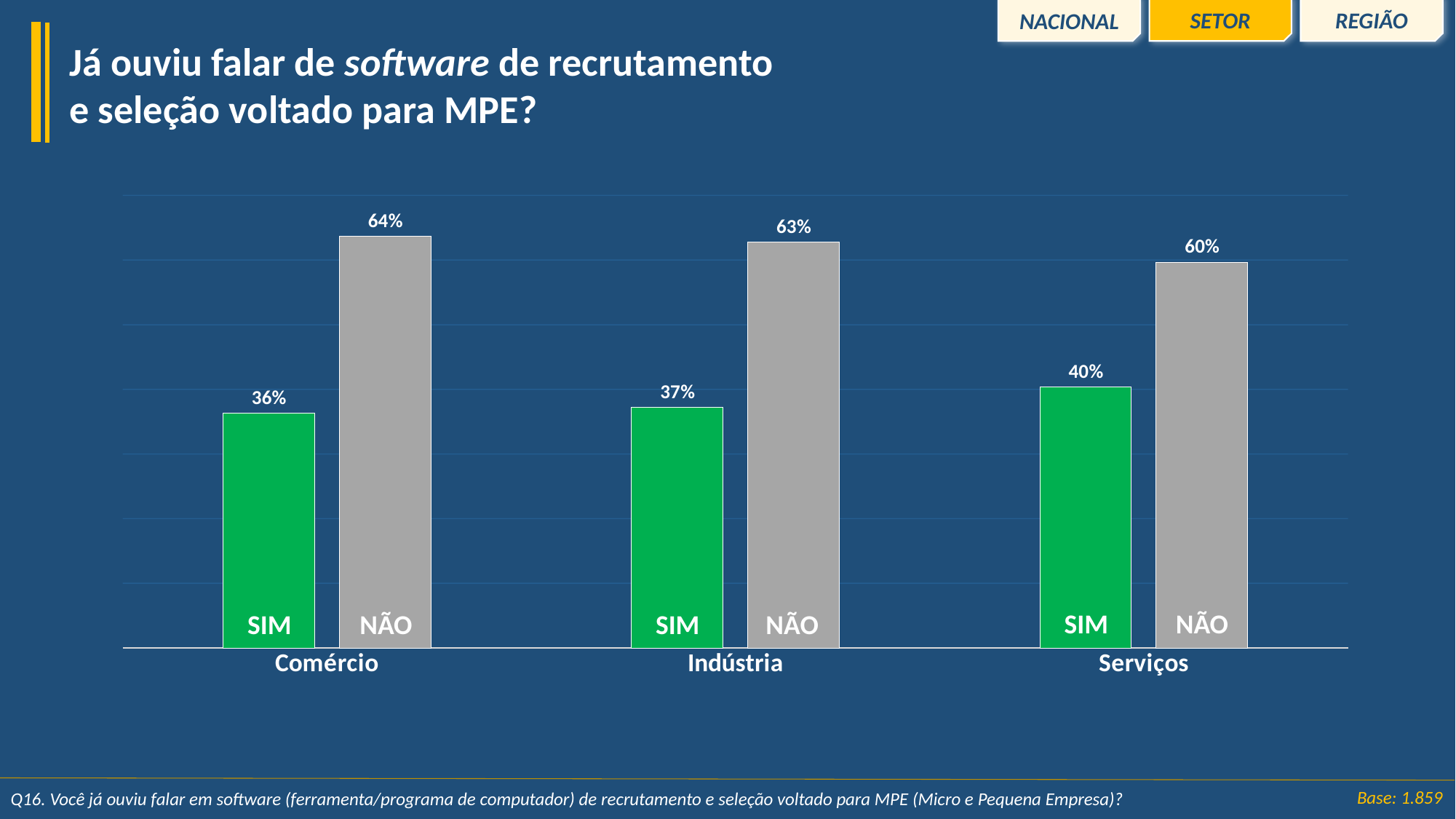
Which is larger for Indústria, SIM or NÃO? NÃO What is the NÃO value for Indústria? 63% What is the difference between the NÃO and SIM values for Comércio? 28% Which sector has the highest SIM value? Serviços What is the SIM value for Comércio? 36% What colour are the SIM bars? Green What kind of chart is shown on the slide? Bar chart Which sector has the lowest NÃO value? Serviços What is the SIM value for Serviços? 40% What is the NÃO value for Serviços? 60% How many series (SIM and NÃO) are plotted for each sector? 2 How many sectors are shown on the x axis? 3